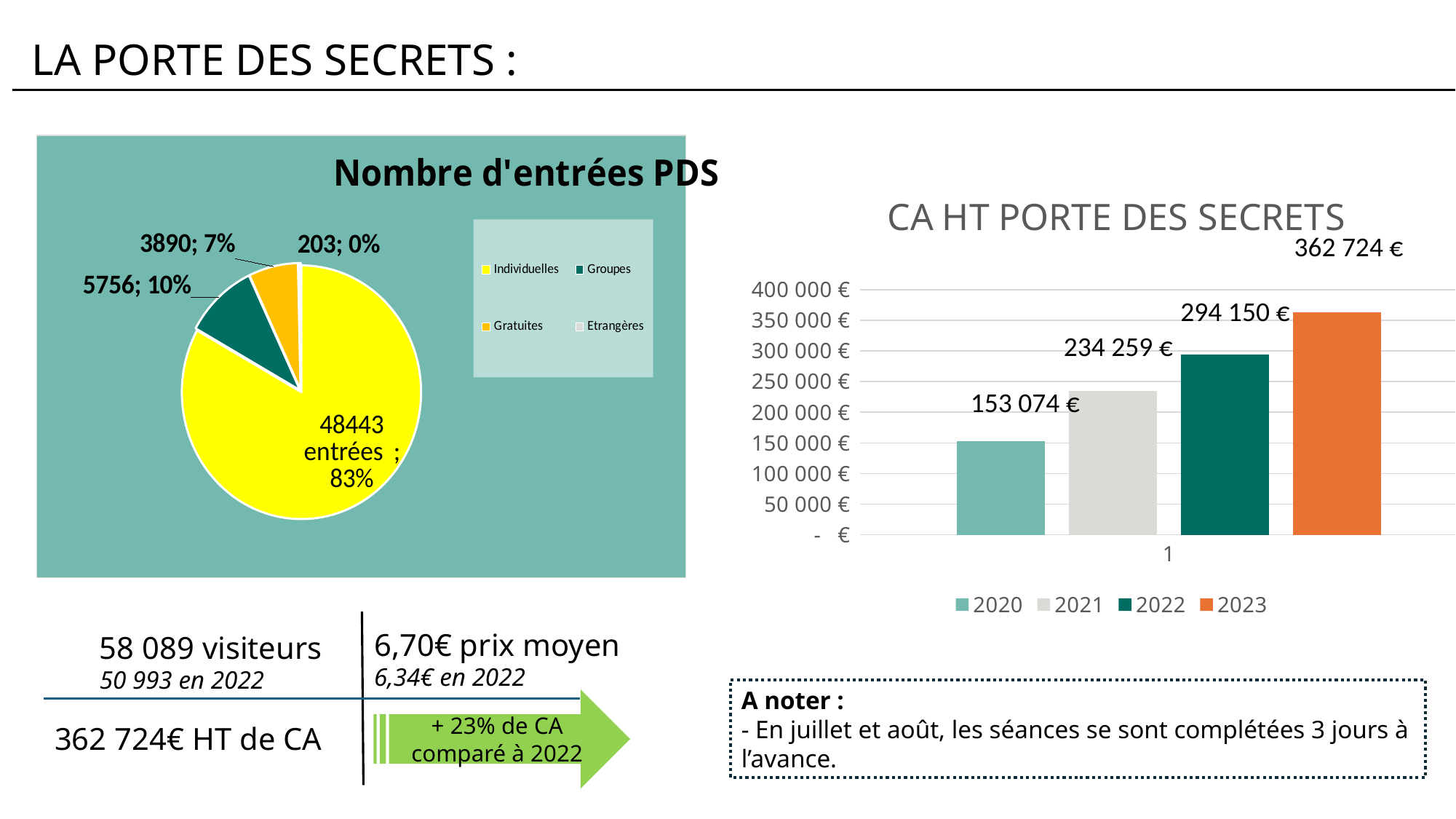
In the chart titled "CA HT PORTE DES SECRETS", what is the difference between the 2023 and 2022 values? 68 574 € In the pie chart "Nombre d'entrées PDS", which is larger: Groupes or Gratuites? Groupes In the chart titled "CA HT PORTE DES SECRETS", what is the value for 2023? 362 724 € In the pie chart "Nombre d'entrées PDS", what share do Individuelles entries represent? 83% In the pie chart "Nombre d'entrées PDS", how many entries are Groupes? 5756 In the chart titled "CA HT PORTE DES SECRETS", what is the value for 2020? 153 074 € In the chart titled "CA HT PORTE DES SECRETS", which year has the lowest value? 2020 In the chart titled "CA HT PORTE DES SECRETS", do the values rise or fall from 2020 to 2023? rise What kind of chart is "CA HT PORTE DES SECRETS"? bar chart In the chart titled "CA HT PORTE DES SECRETS", how many series does the legend list? 4 In the chart titled "CA HT PORTE DES SECRETS", which year has the highest value? 2023 In the pie chart "Nombre d'entrées PDS", which category has the smallest slice? Etrangères